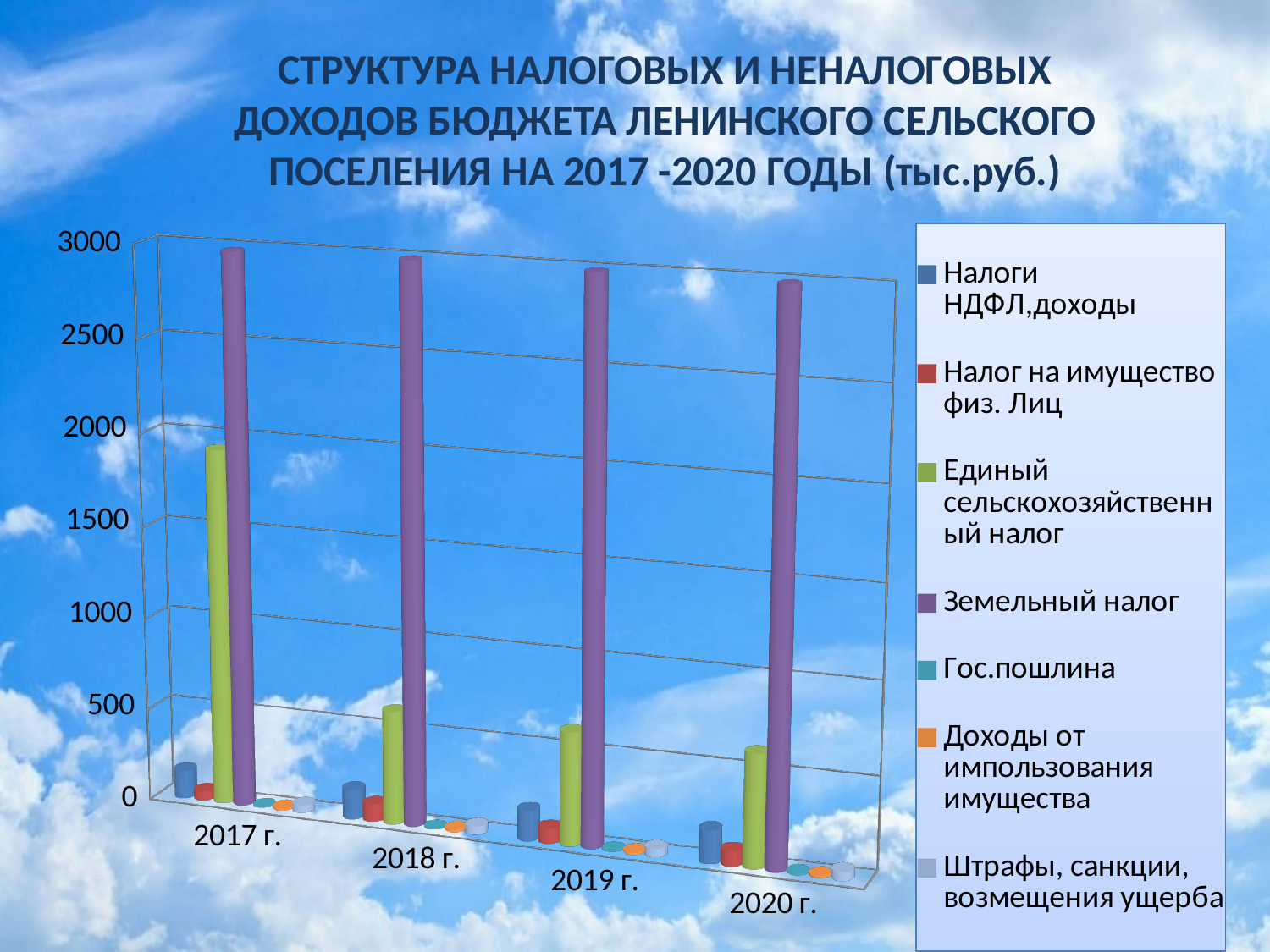
Which series has the highest value in 2020 г.? Земельный налог Is the value of Единый сельскохозяйственный налог in 2019 г. greater or less than 1000? less Does the value of Единый сельскохозяйственный налог rise or fall from 2017 г. to 2020 г.? fall How many series does the chart's legend list? 7 What kind of chart is shown on the slide? bar chart Is the value of Единый сельскохозяйственный налог in 2017 г. greater or less than 1500? greater Which is larger: Единый сельскохозяйственный налог in 2017 г. or in 2018 г.? 2017 г. Is the value of Земельный налог in 2017 г. greater or less than 2500? greater How many years (categories) are shown on the x axis of the chart? 4 Which colour represents Земельный налог in the legend? purple Which series has the highest value in 2017 г.? Земельный налог